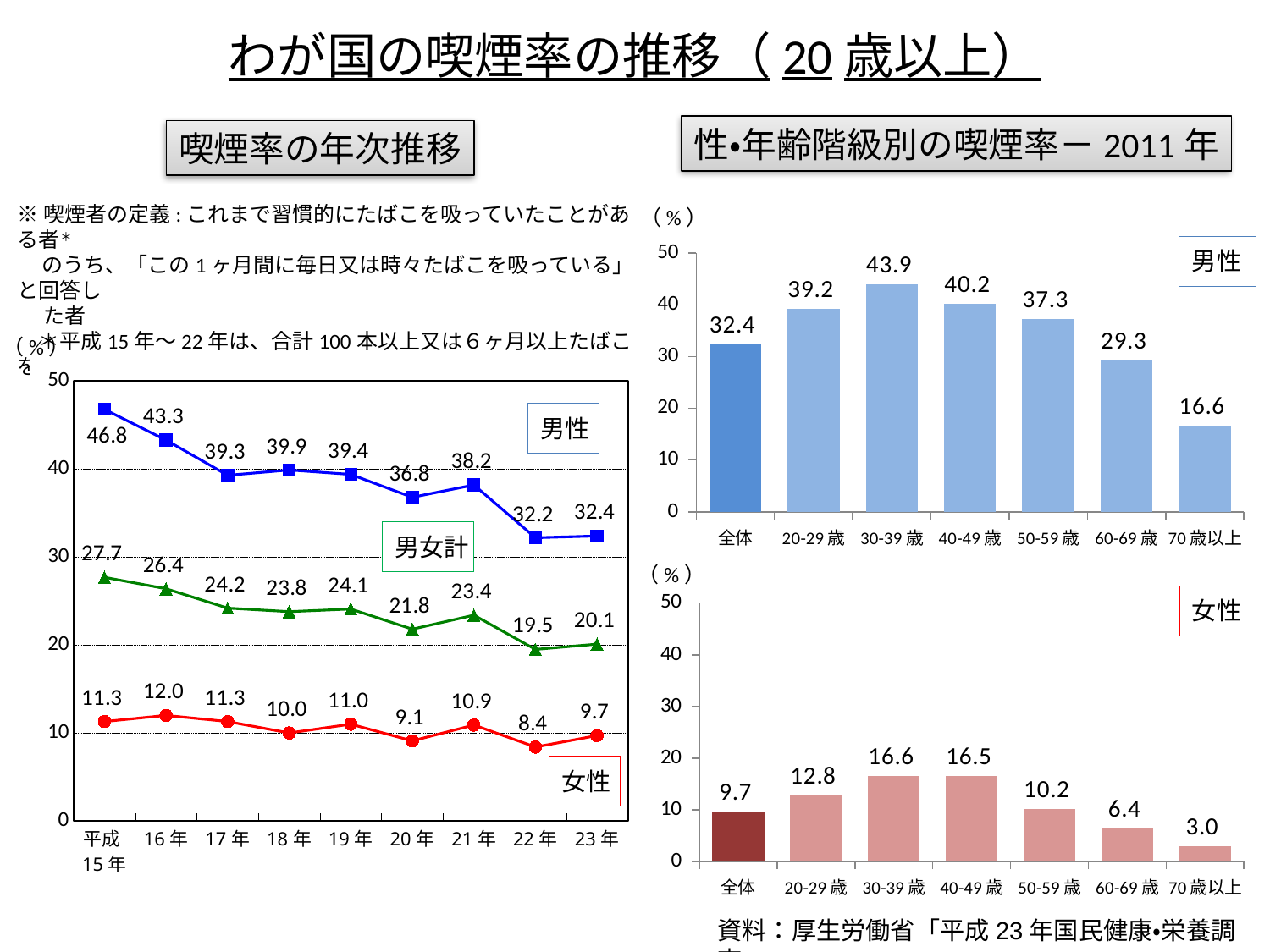
In the line chart 喫煙率の年次推移, what is the difference between the 男女計 value in 平成15年 and in 23年? 7.6 In the line chart 喫煙率の年次推移, what is the 女性 smoking rate in 22年? 8.4 What kind of chart is 喫煙率の年次推移 on the left of the slide? line chart In the line chart 喫煙率の年次推移, what is the 男性 smoking rate in 平成15年? 46.8 In the line chart 喫煙率の年次推移, does the 男性 series generally rise or fall from 平成15年 to 23年? fall In the 男性 bar chart on the right, which age group has the highest smoking rate? 30-39歳 In the 女性 bar chart on the right, which age group has the lowest smoking rate? 70歳以上 In the 男性 bar chart on the right, what is the smoking rate for 30-39歳? 43.9 In the 女性 bar chart on the right, which is larger, the value for 20-29歳 or for 50-59歳? 20-29歳 In the 男性 bar chart on the right, how many bars are shown? 7 In the 男性 bar chart on the right, what is the difference between the 20-29歳 and 70歳以上 values? 22.6 In the line chart 喫煙率の年次推移, how many series are plotted? 3